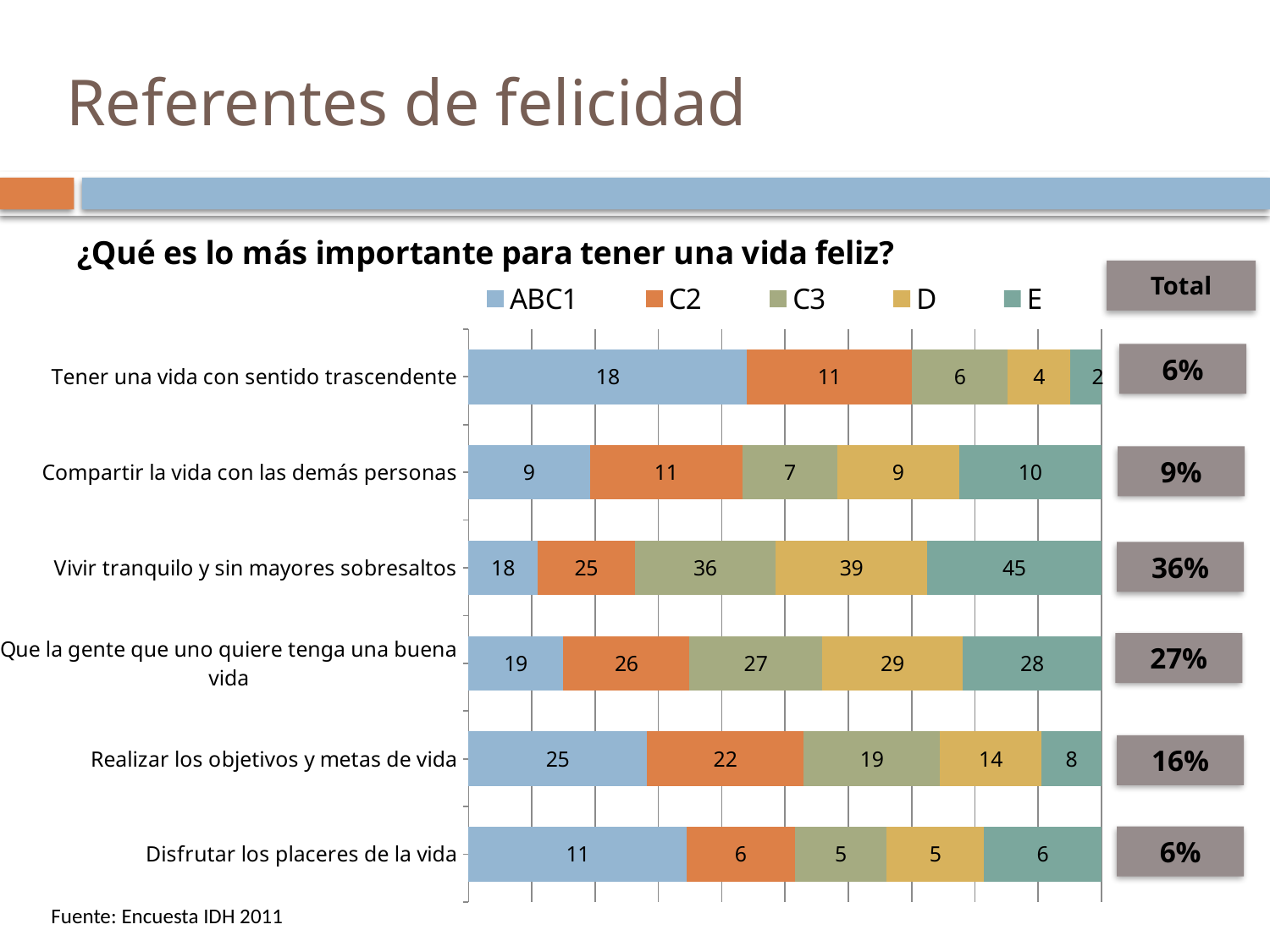
What is the title of the chart? ¿Qué es lo más importante para tener una vida feliz? What is the value for series ABC1 in the category 'Realizar los objetivos y metas de vida'? 25 What is the difference between the C2 value for 'Vivir tranquilo y sin mayores sobresaltos' and the C2 value for 'Realizar los objetivos y metas de vida'? 3 In the category 'Vivir tranquilo y sin mayores sobresaltos', which series has the highest value? E What kind of chart is shown on the slide? Stacked bar chart How many series does the legend list? 5 What is the value for series D in the category 'Que la gente que uno quiere tenga una buena vida'? 29 Which category has the larger C3 value: 'Vivir tranquilo y sin mayores sobresaltos' or 'Que la gente que uno quiere tenga una buena vida'? Vivir tranquilo y sin mayores sobresaltos How many categories (answer options) are plotted on the chart? 6 What is the value for series E in the category 'Vivir tranquilo y sin mayores sobresaltos'? 45 For series E, which category has the lowest value? Tener una vida con sentido trascendente For series ABC1, which category has the highest value? Realizar los objetivos y metas de vida